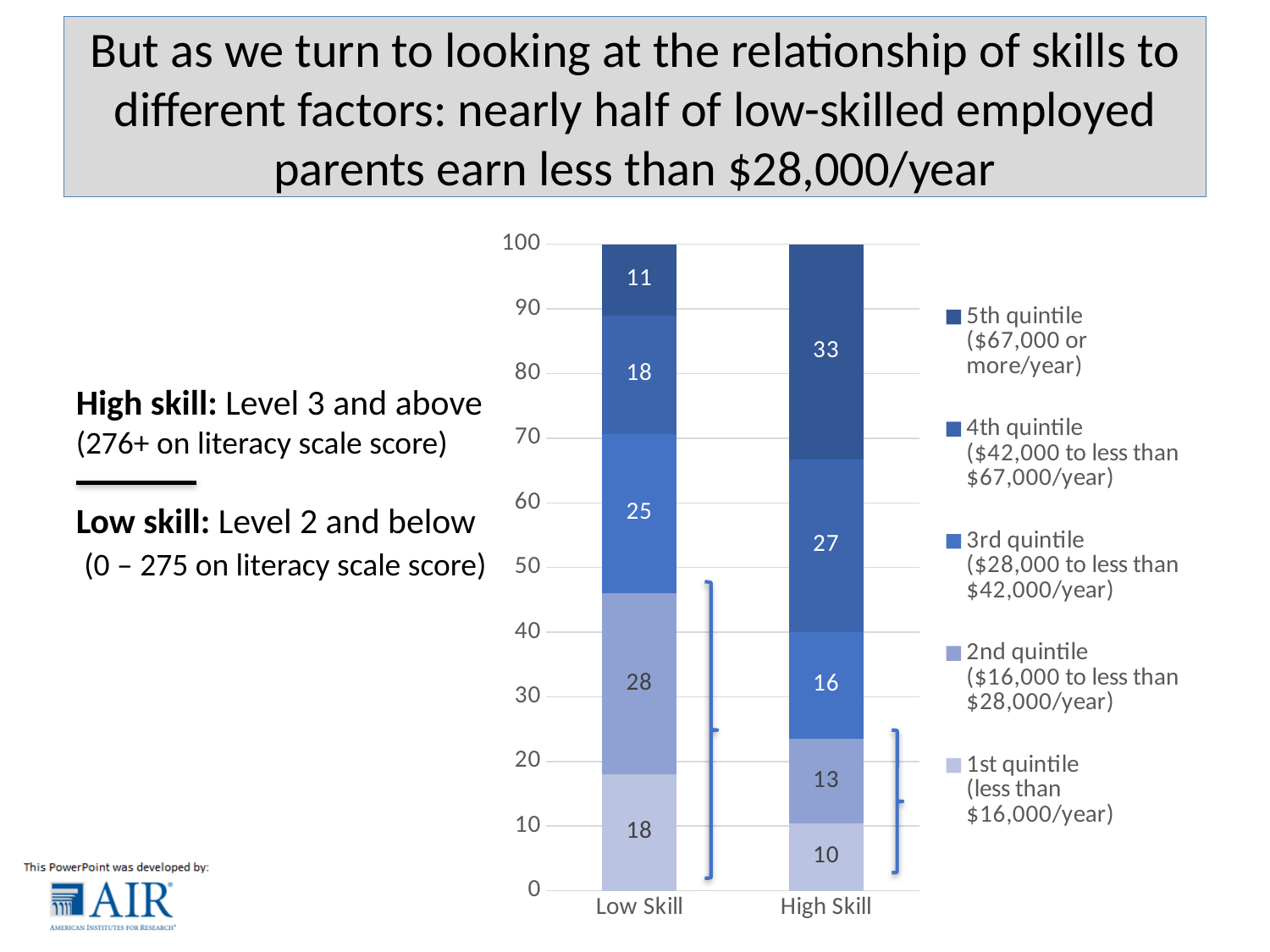
Which is larger: the 4th quintile value for Low Skill or for High Skill? High Skill What is the total of the Low Skill stacked bar? 100 Which quintile segment is the smallest in the High Skill bar? 1st quintile What is the difference between the 5th quintile values for High Skill and Low Skill? 22 What is the value of the 5th quintile segment for High Skill? 33 What is the value of the 3rd quintile segment for High Skill? 16 What is the value of the 2nd quintile segment for Low Skill? 28 How many categories are shown on the x axis of the chart? 2 Which quintile segment is the largest in the Low Skill bar? 2nd quintile What kind of chart is shown on the slide? Stacked bar chart How many series does the chart's legend list? 5 What is the value of the 1st quintile segment for Low Skill? 18